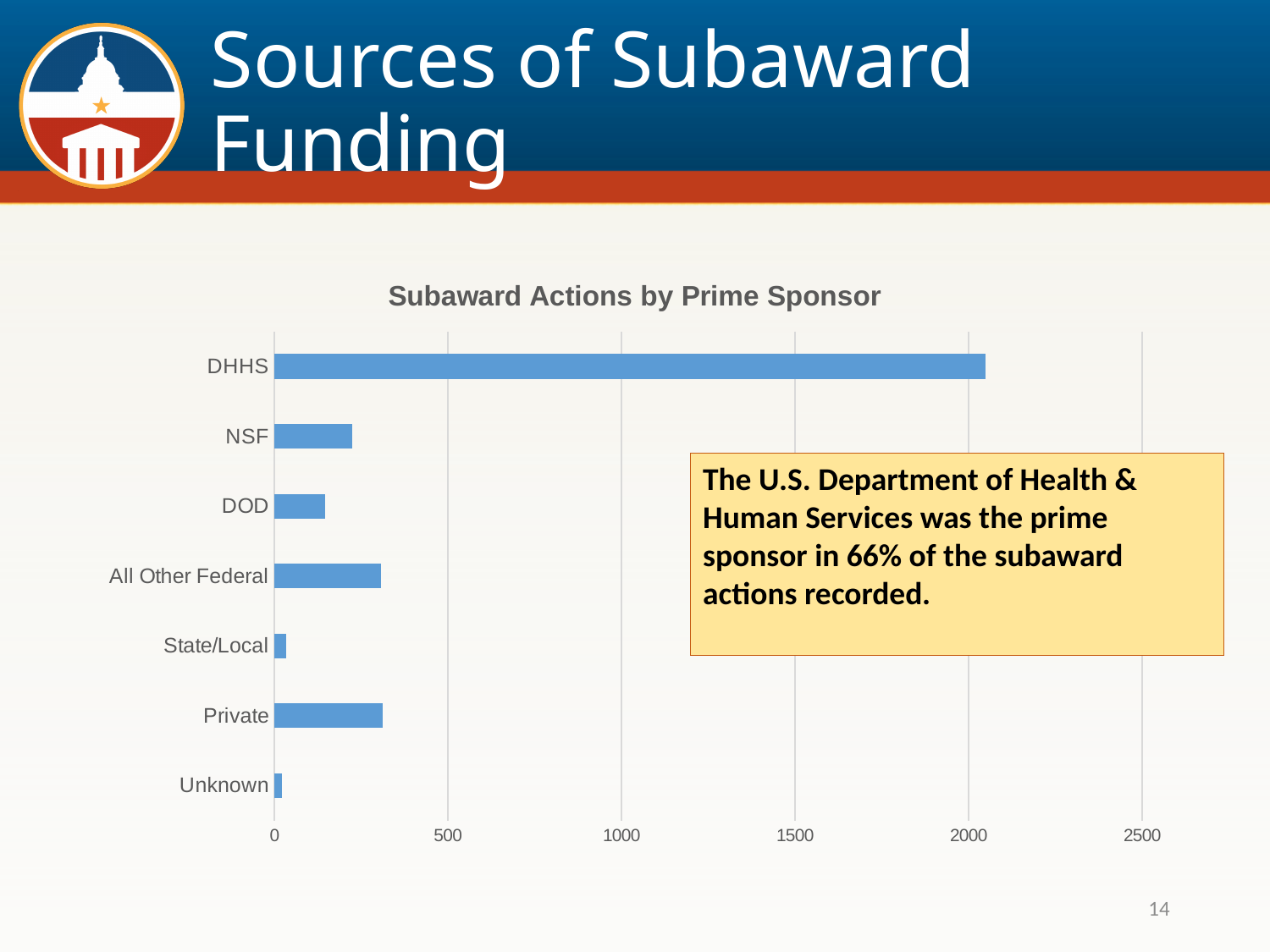
Which has more subaward actions, DHHS or Private? DHHS What is the title of the chart? Subaward Actions by Prime Sponsor According to the text box on the slide, in what percentage of subaward actions was DHHS the prime sponsor? 66% What kind of chart is shown on the slide? bar chart Is the value for DHHS greater or less than 2500? less How many prime sponsor categories are shown in the chart? 7 Which has more subaward actions, All Other Federal or State/Local? All Other Federal Is the value for DHHS greater or less than 2000? greater Is the value for All Other Federal greater or less than 500? less Which has more subaward actions, NSF or DOD? NSF Which prime sponsor has the highest number of subaward actions? DHHS